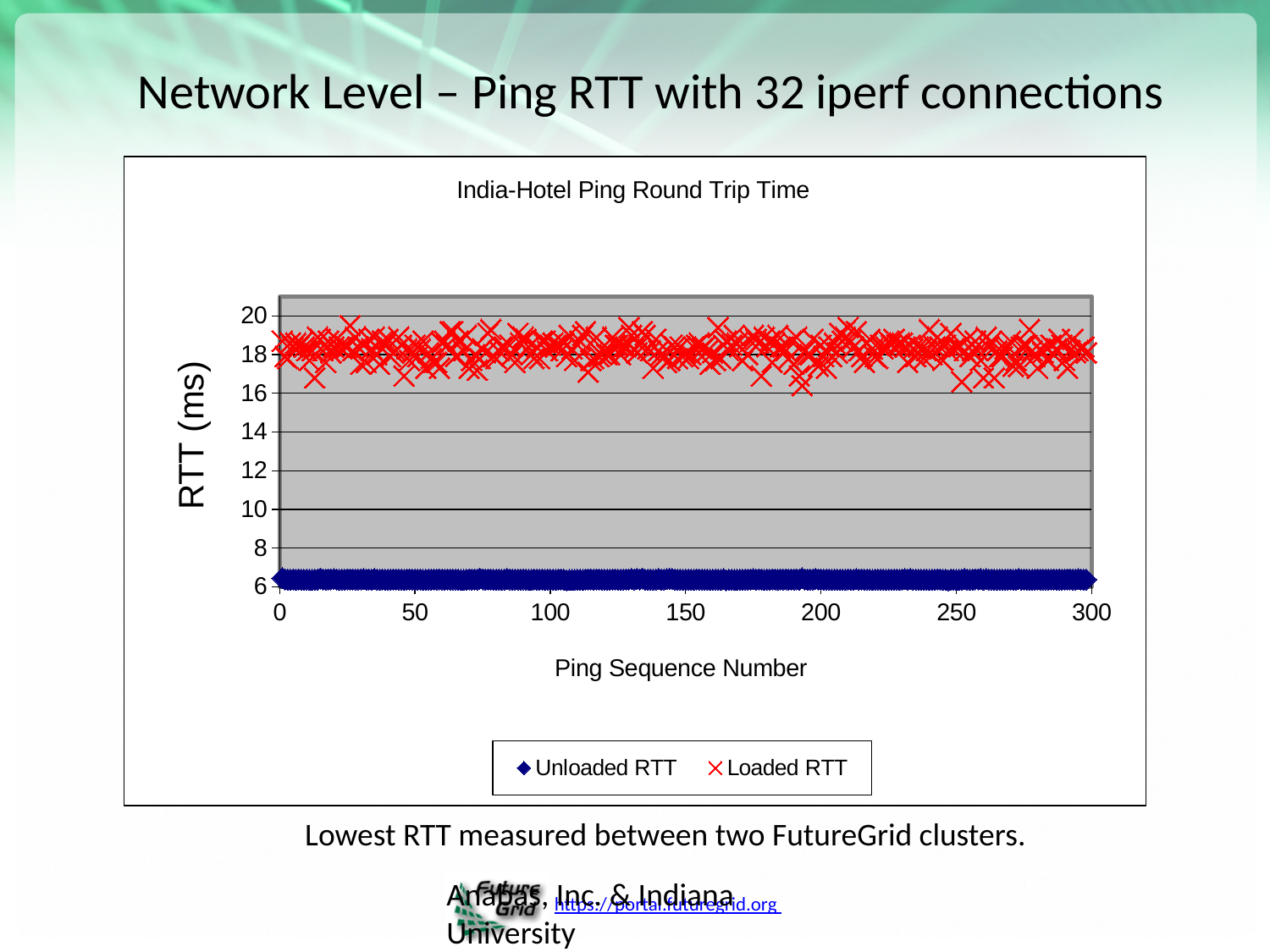
Are the Loaded RTT values greater or less than 20 ms? less How many series does the chart's legend list? 2 Are the Unloaded RTT values greater or less than 8 ms? less What is the label of the y axis? RTT (ms) Are the Unloaded RTT values greater or less than 10 ms? less Which series has the higher RTT values, Unloaded RTT or Loaded RTT? Loaded RTT What are the two series named in the legend? Unloaded RTT and Loaded RTT Do the Unloaded RTT values rise, fall, or stay roughly flat as the ping sequence number increases? stay roughly flat What kind of chart is shown on the slide? scatter chart What is the label of the x axis? Ping Sequence Number